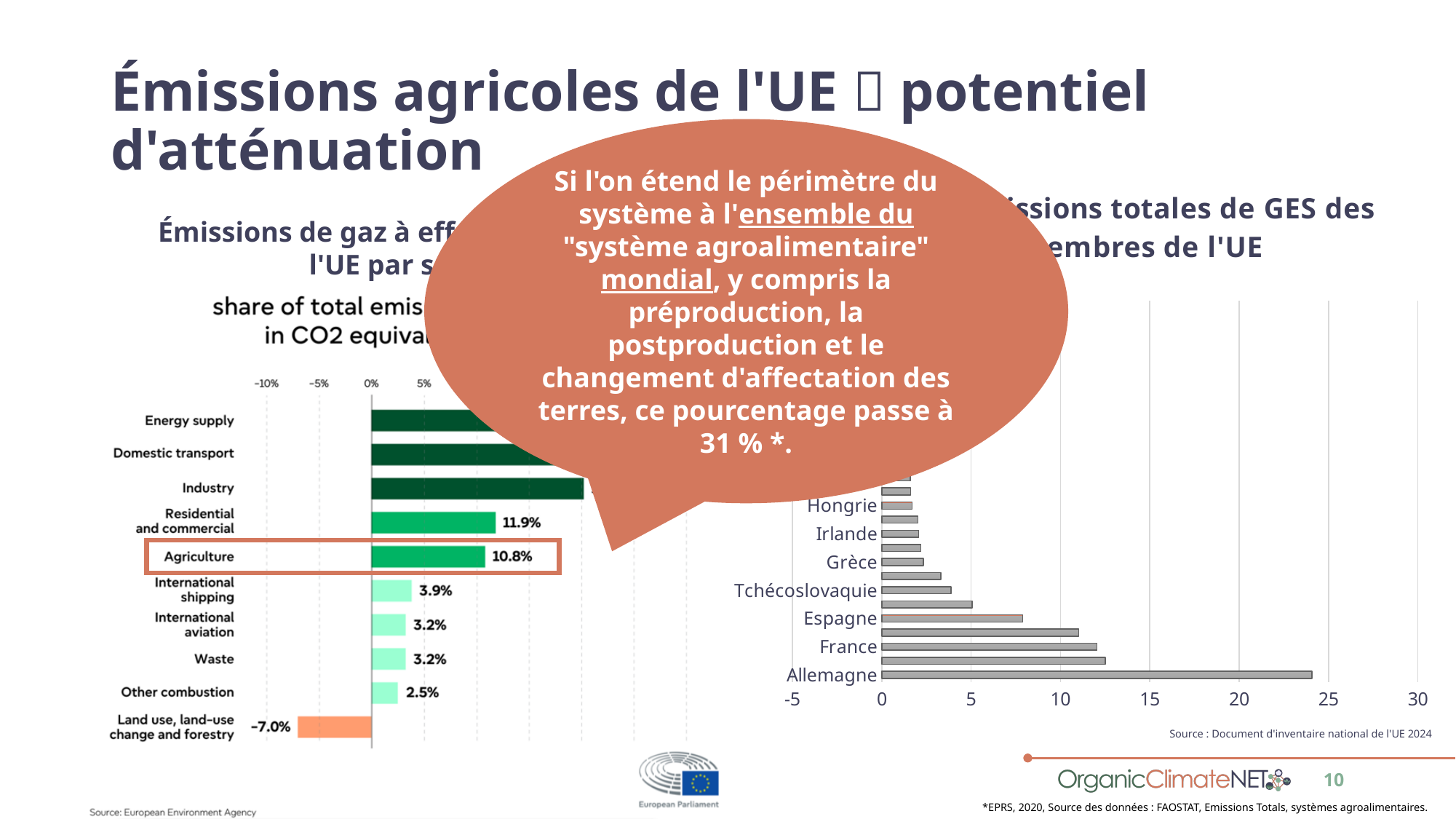
In the left chart, what is the value for Residential and commercial? 11.9% In the left chart, which category is highlighted with an orange box? Agriculture In the left chart, is the value for Industry greater or less than 5%? greater In the left chart, which category has the lowest value? Land use, land-use change and forestry What kind of chart is the right chart showing emissions of EU member states? bar chart In the left chart, what is the difference between Residential and commercial and Agriculture? 1.1 percentage points In the left chart, what is the value for Land use, land-use change and forestry? -7.0% In the right chart (total GHG emissions of EU member states), is the value for Allemagne greater or less than 20? greater In the left chart, what is the value for International shipping? 3.9% In the left chart, what is the value for Other combustion? 2.5% In the left chart, which is larger: Residential and commercial or Agriculture? Residential and commercial In the left chart (share of total emissions in CO2 equivalent), what is the value for Agriculture? 10.8%